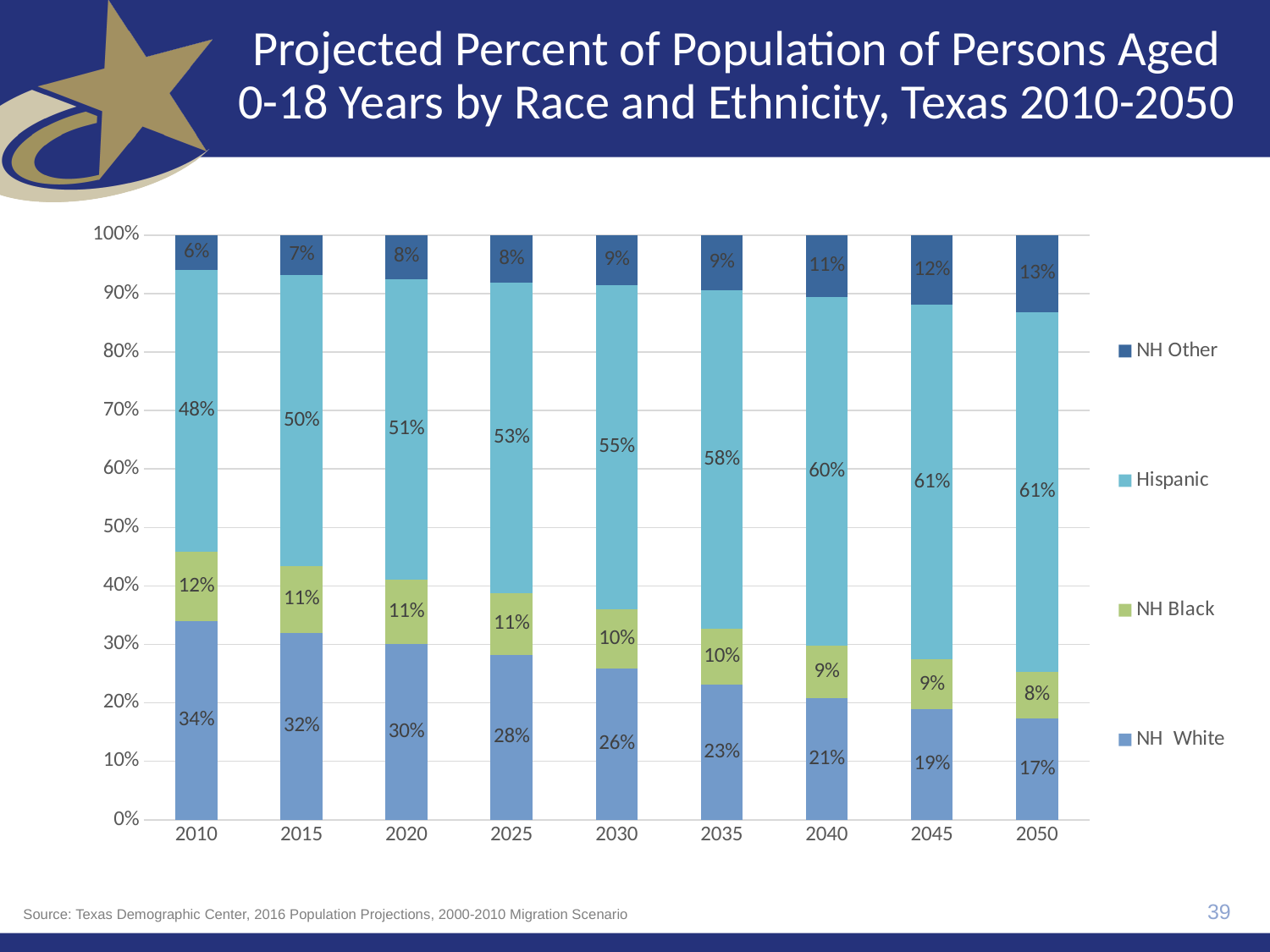
What is the NH Black value for 2025? 11% Which is larger in 2040: the NH White value or the NH Other value? NH White In which year is the NH Black share lowest? 2050 How many series does the legend list? 4 What is the NH White value for 2050? 17% What is the difference between the Hispanic value in 2050 and the Hispanic value in 2010? 13% What is the NH Other value for 2010? 6% How many years are shown on the x axis? 9 What kind of chart is shown on the slide? Stacked bar chart In which year is the NH White share highest? 2010 What is the Hispanic share of the population aged 0-18 in 2030? 55% Does the NH White share rise or fall from 2010 to 2050? Fall